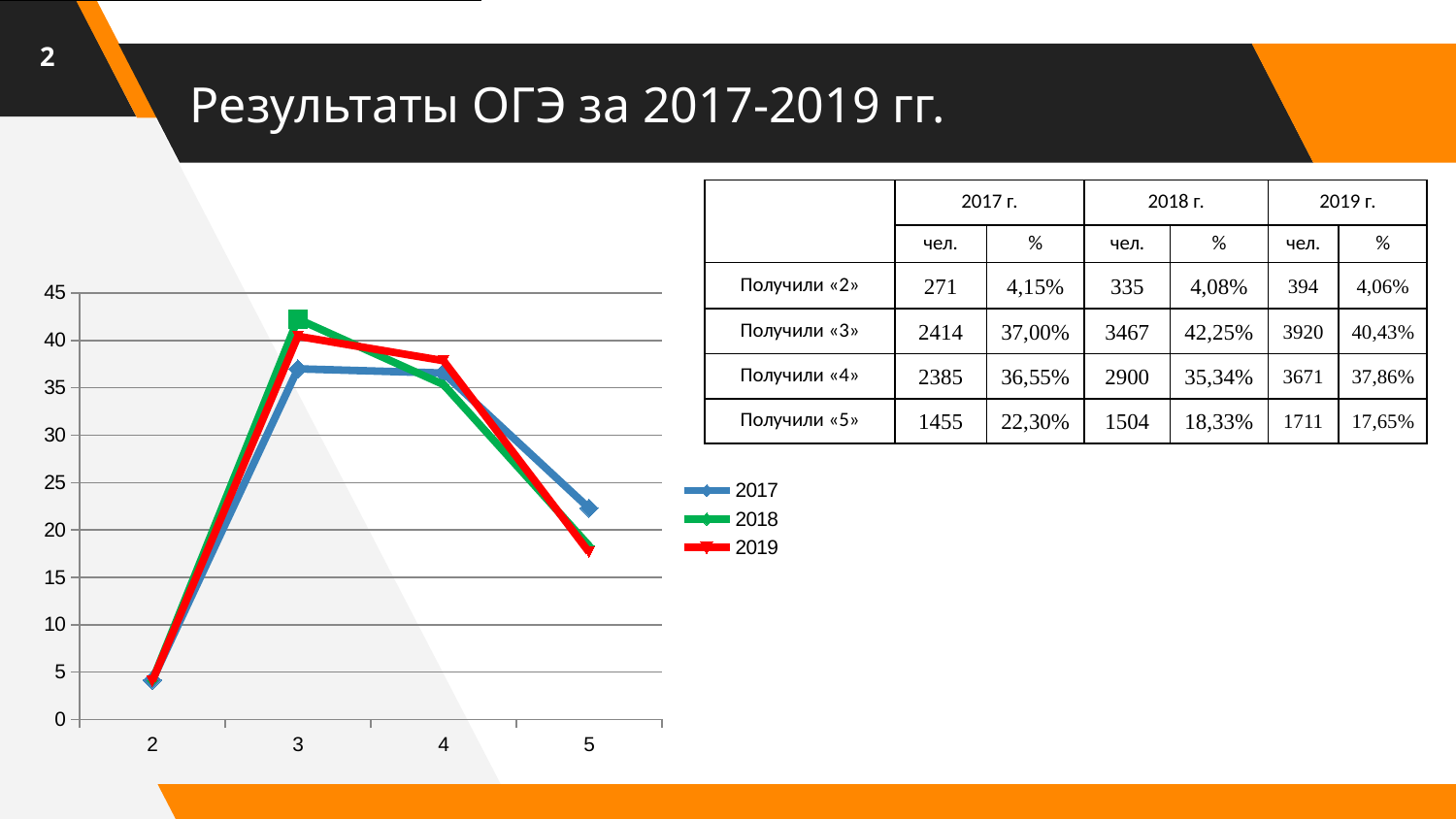
For the 2019 series, at which x-axis category is the value lowest? 2 At category 3, which series has the larger value, 2017 or 2018? 2018 Do the values of the 2017 series rise or fall from category 4 to category 5? fall Is the value for the 2019 series at category 5 greater or less than 20? less At category 5, which series has the larger value, 2017 or 2019? 2017 What kind of chart is shown on the slide? line chart For the 2018 series, at which x-axis category is the value highest? 3 How many categories are shown along the x axis of the chart? 4 Which colour is used for the 2019 series in the chart? red Is the value for the 2017 series at category 5 greater or less than 20? greater How many series does the chart legend list? 3 Is the value for the 2018 series at category 2 greater or less than 10? less